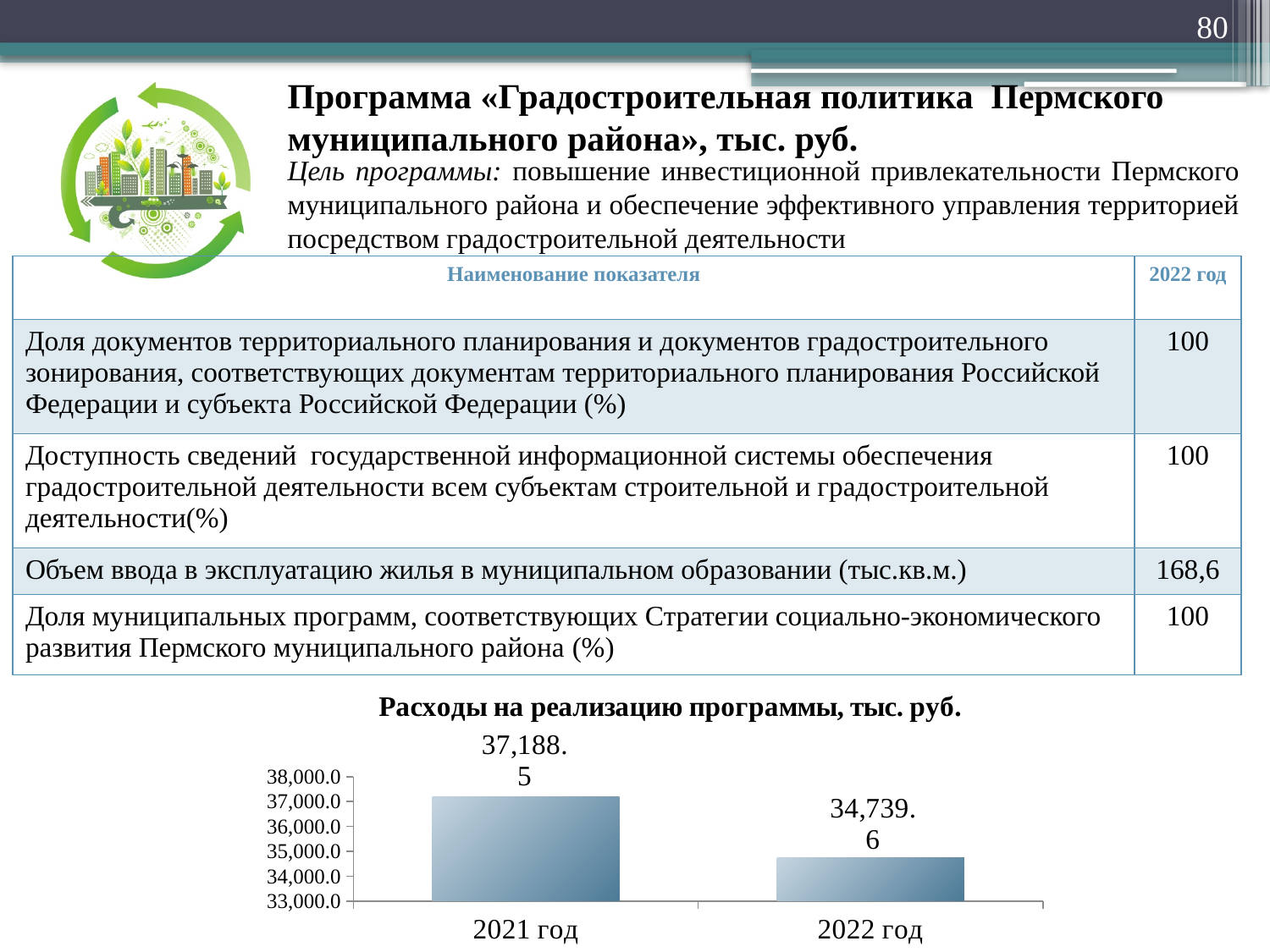
How many bars are shown in the chart? 2 What is the value for 2022 год in the chart? 34,739.6 Which year has the lowest value in the chart? 2022 год What type of chart is shown under the table? bar chart Is the value for 2021 год greater or less than 37,000.0? greater Is the value for 2022 год greater or less than 35,000.0? less What is the title of the chart on the slide? Расходы на реализацию программы, тыс. руб. What is the value for 2021 год in the chart? 37,188.5 Which year has the highest value in the chart? 2021 год What is the difference between the values for 2021 год and 2022 год? 2,448.9 Do the values rise or fall from 2021 год to 2022 год? fall Which is larger, the value for 2021 год or for 2022 год? 2021 год